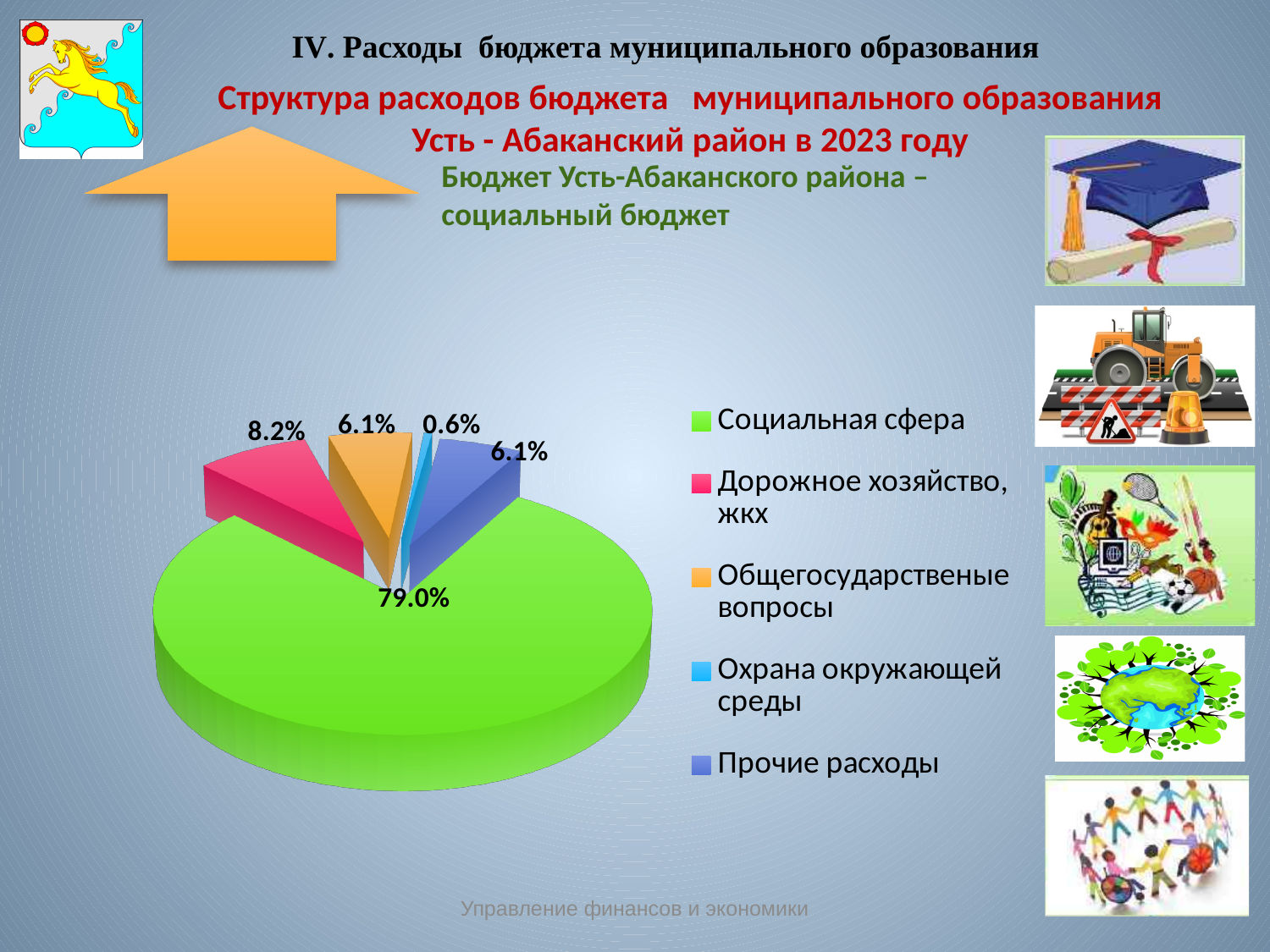
How many categories does the pie chart have? 5 What colour is the slice for Социальная сфера? green What is the difference between the values for Социальная сфера and Дорожное хозяйство, жкх? 70.8% What is the value for Прочие расходы? 6.1% What share of the pie does Социальная сфера have? 79.0% Which category has the largest slice of the pie? Социальная сфера What is the value for Дорожное хозяйство, жкх? 8.2% Which category has the smallest slice of the pie? Охрана окружающей среды What is the value for Охрана окружающей среды? 0.6% Which is larger: Дорожное хозяйство, жкх or Прочие расходы? Дорожное хозяйство, жкх What type of chart is shown on the slide? pie chart What is the value for Общегосударственые вопросы? 6.1%